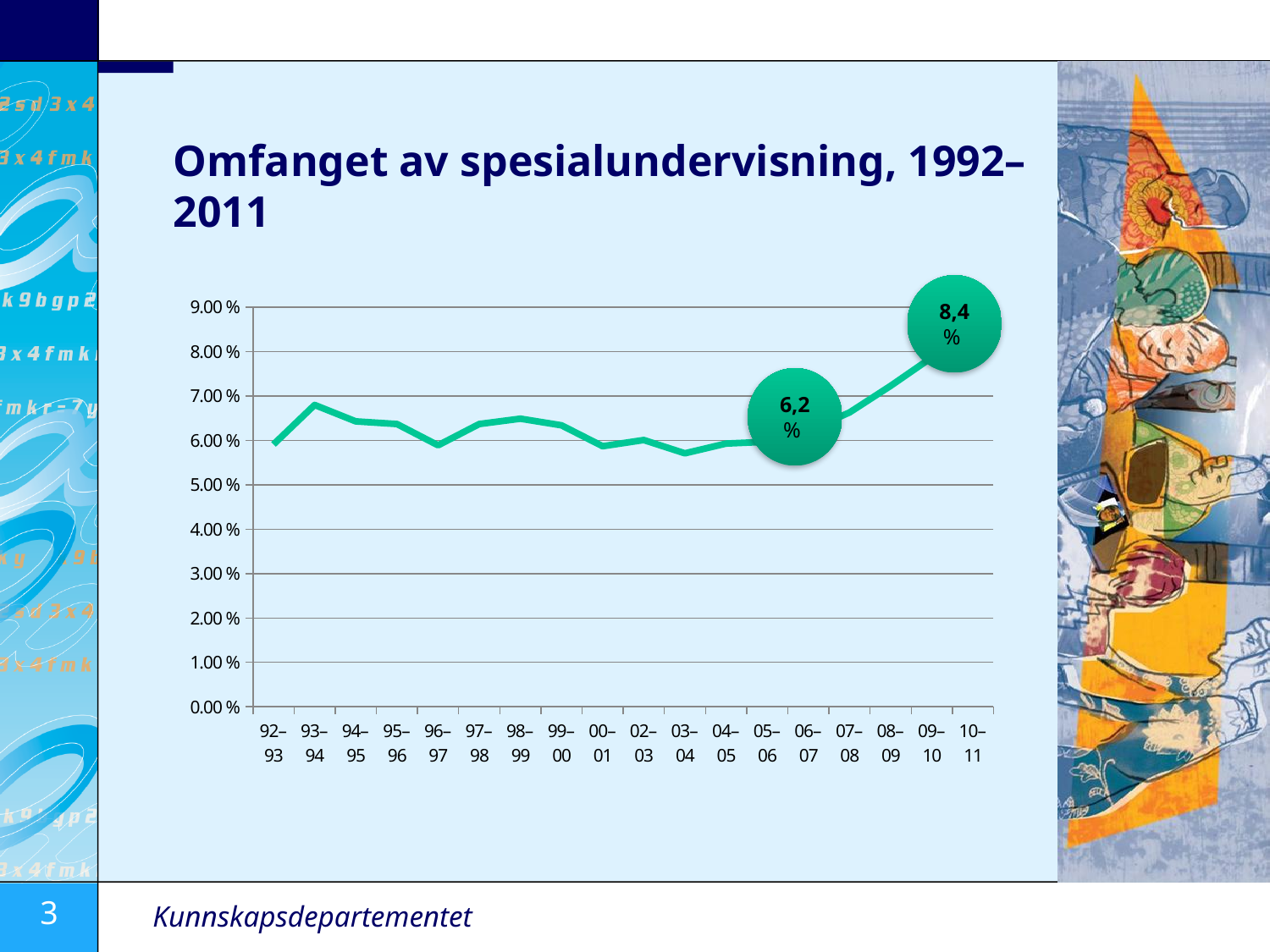
How many school years are shown on the x axis? 18 Is the value for 10–11 greater or less than 8.00 %? greater What type of chart is shown on the slide? line chart What is the lower of the two values printed in data labels on the chart? 6,2 % Is the value for 03–04 greater or less than 6.00 %? less Which school year has the lowest value on the chart? 03–04 Is the value for 93–94 greater or less than 6.00 %? greater Which school year has the highest value on the chart? 10–11 What is the title of the chart? Omfanget av spesialundervisning, 1992–2011 What is the difference between the two labelled values, 8,4 % and 6,2 %? 2,2 percentage points What value is shown in the data label at the end of the line, for 10–11? 8,4 % Does the line rise or fall between 06–07 and 10–11? rises